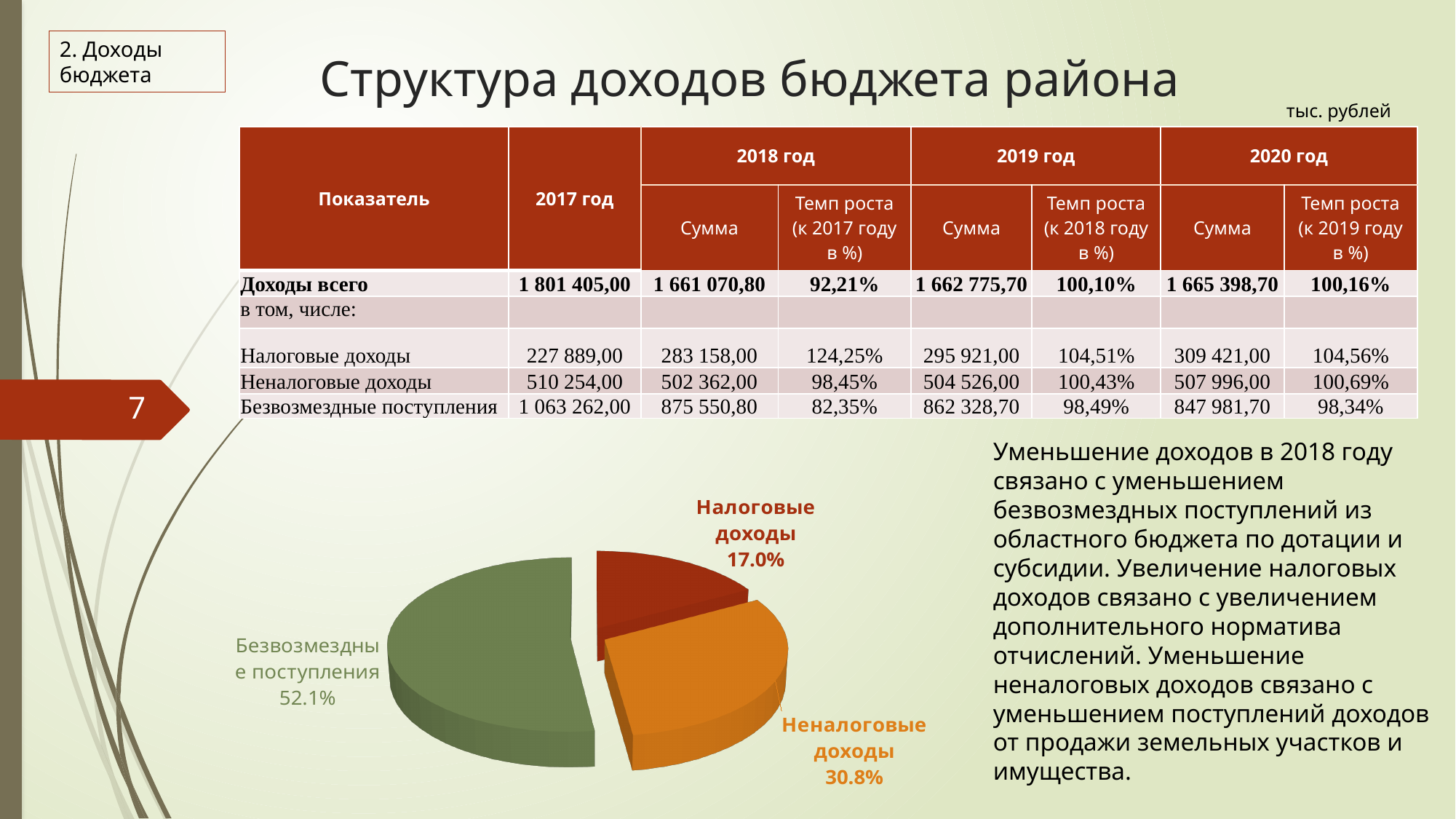
What share of the pie chart is Налоговые доходы? 17.0% Is the share of Безвозмездные поступления in the pie chart greater or less than 50%? greater Which slice of the pie chart is the smallest? Налоговые доходы What share of the pie chart is Неналоговые доходы? 30.8% Which is larger in the pie chart, Неналоговые доходы or Налоговые доходы? Неналоговые доходы How many slices does the pie chart have? 3 Which slice of the pie chart is the largest? Безвозмездные поступления What colour is the Безвозмездные поступления slice in the pie chart? green What is the difference in percentage points between Неналоговые доходы and Налоговые доходы in the pie chart? 13.8 What is the difference in percentage points between Безвозмездные поступления and Неналоговые доходы in the pie chart? 21.3 What kind of chart is shown on the slide? pie chart What share of the pie chart is Безвозмездные поступления? 52.1%